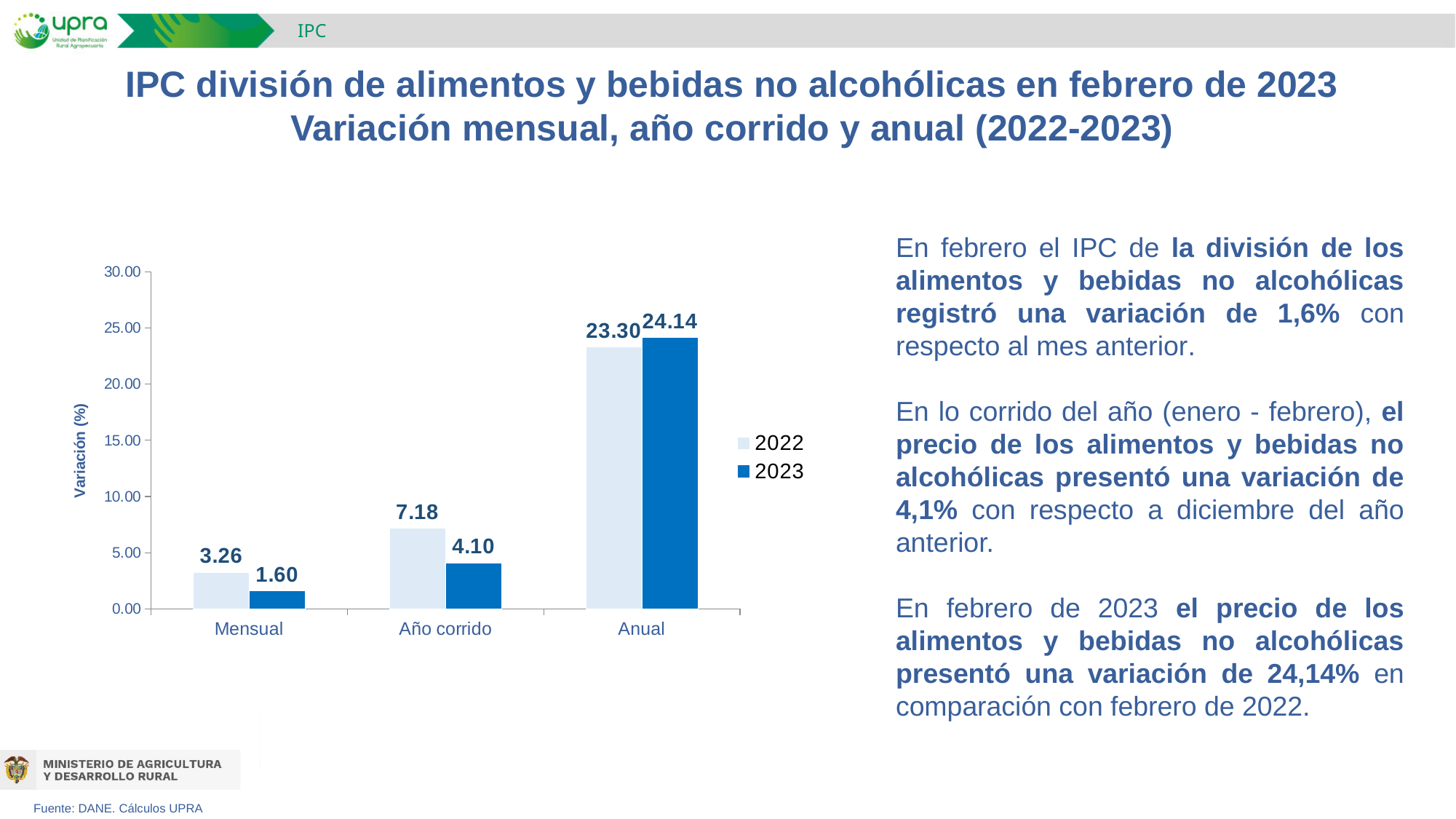
How many series does the legend list? 2 What is the label of the y axis? Variación (%) Which category has the lowest value for the 2022 series? Mensual What is the difference between the 2022 and 2023 values in the Año corrido category? 3.08 In the Anual category, which series has the larger value, 2022 or 2023? 2023 What is the value for 2023 in the Año corrido category? 4.10 What kind of chart is shown on the slide? bar chart Is the 2022 value for Anual greater or less than 20.00? greater How many categories are shown on the x axis? 3 What is the value for 2022 in the Mensual category? 3.26 Which category has the highest value for the 2023 series? Anual What is the value for 2023 in the Anual category? 24.14